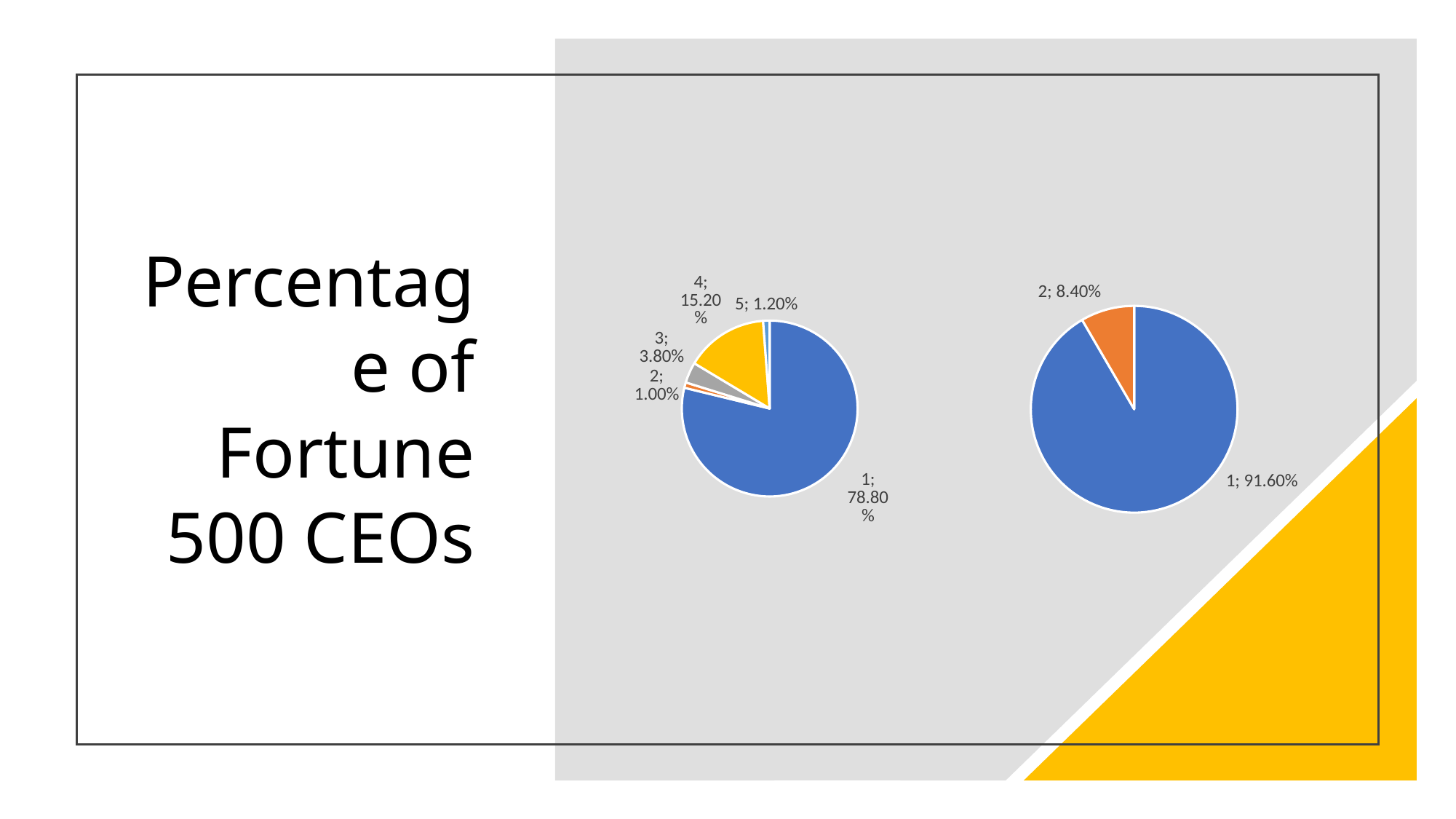
On the right pie chart, what is the value for category 1? 91.60% On the left pie chart, what is the value for category 1? 78.80% On the left pie chart, what is the value for category 3? 3.80% On the left pie chart, which category has the largest slice? 1 What kind of chart is shown on the right side of the slide? pie chart On the right pie chart, what is the value for category 2? 8.40% On the right pie chart, what is the difference between the values for category 1 and category 2? 83.20% On the left pie chart, what is the difference between the values for category 4 and category 3? 11.40% On the left pie chart, which category has the smallest slice? 2 On the left pie chart, what is the value for category 4? 15.20% On the left pie chart, which is larger, the value for category 5 or the value for category 2? 5 How many slices does the left pie chart have? 5